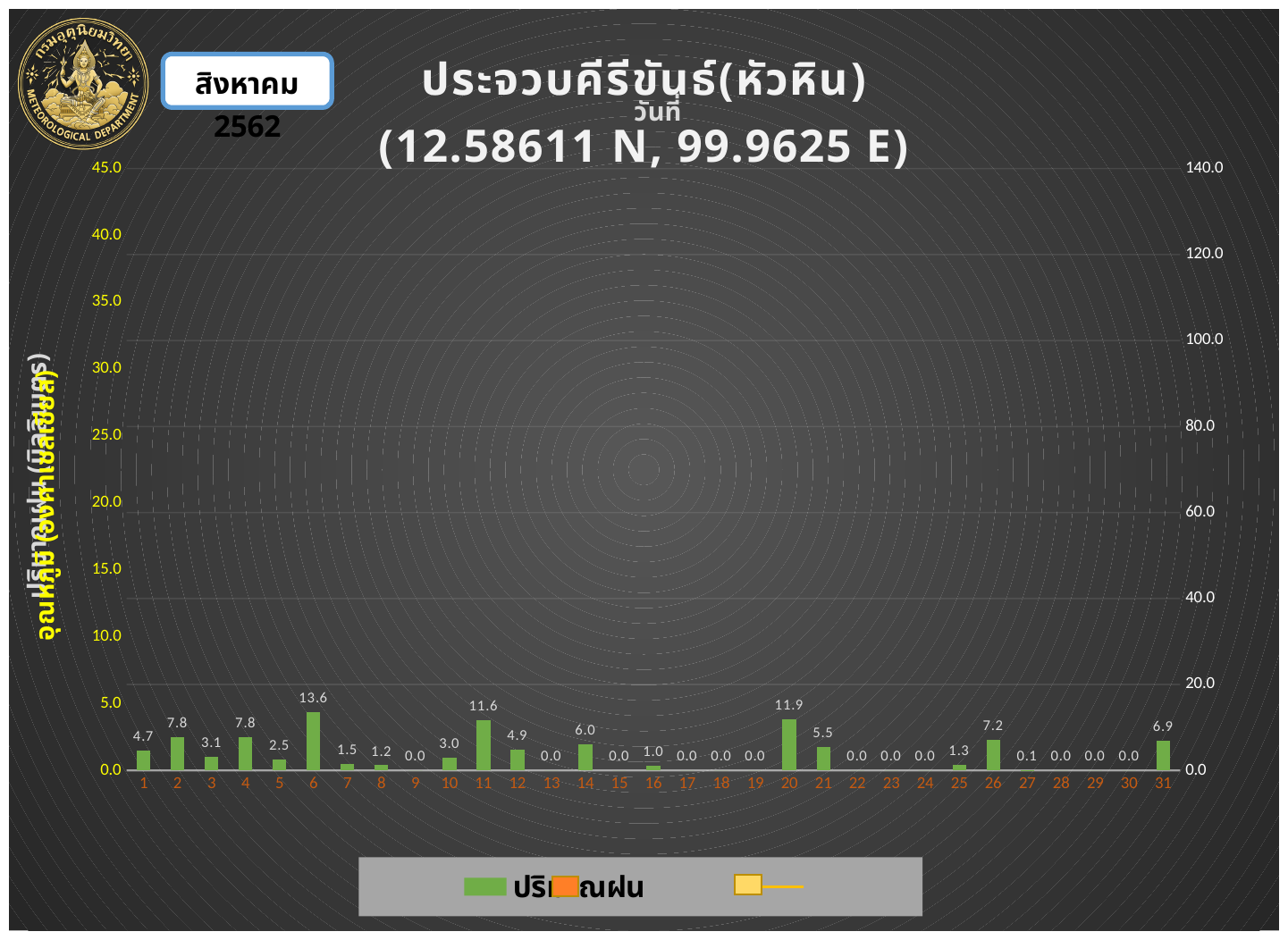
What is the rainfall value shown for day 11? 11.6 What kind of chart is shown on the slide? bar chart What is the rainfall value shown for day 27? 0.1 What month and year are shown in the box at the top left of the slide? สิงหาคม 2562 Which day has the highest rainfall value? 6 What is the difference between the rainfall values for day 2 and day 3? 4.7 What is the rainfall value shown for day 6? 13.6 What is the rainfall value shown for day 20? 11.9 How many days are shown on the x axis? 31 Which has a larger rainfall value, day 11 or day 21? day 11 What is the difference between the rainfall values for day 6 and day 20? 1.7 Which has a larger rainfall value, day 26 or day 31? day 26